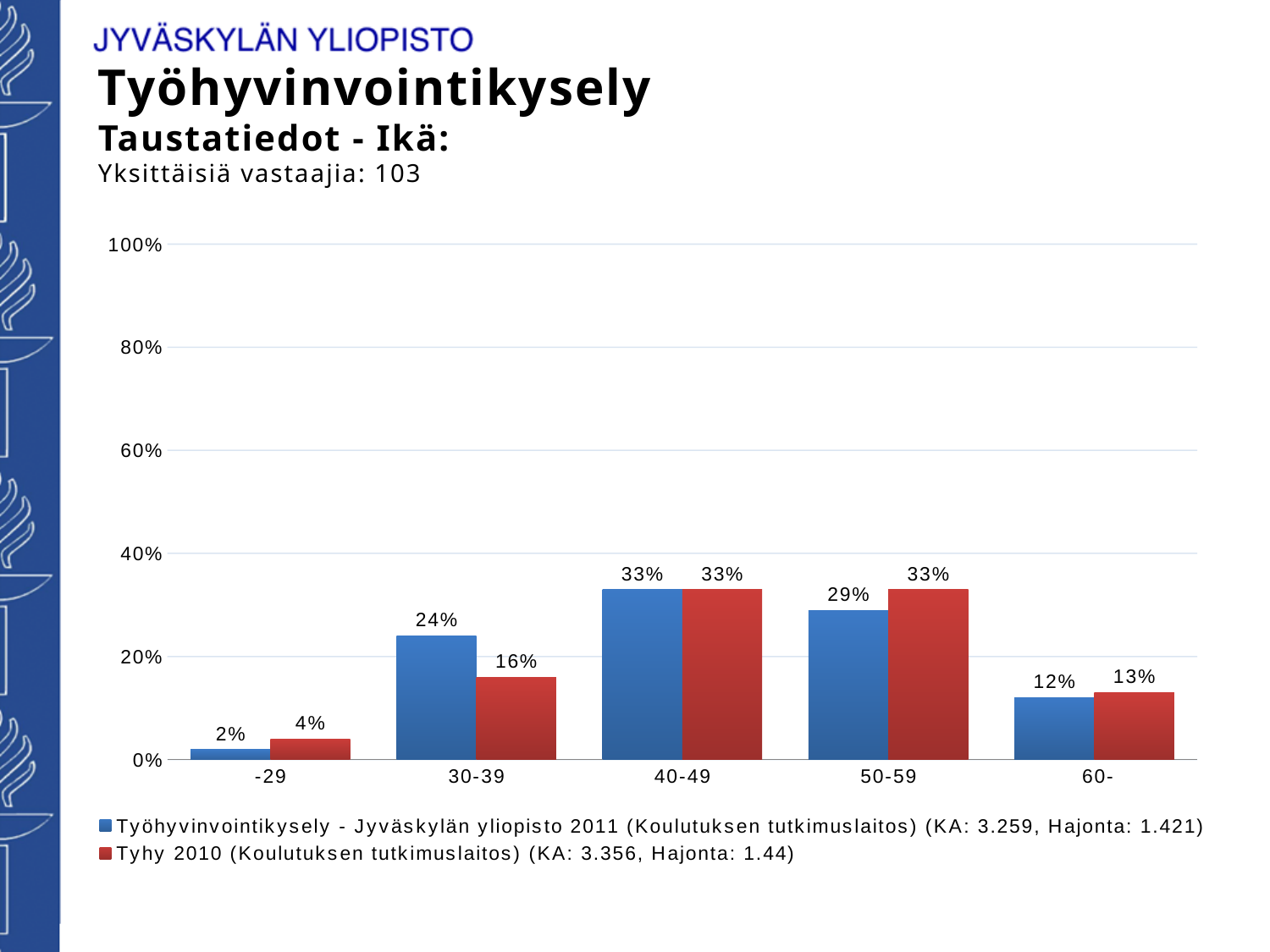
What is the value for the 30-39 age group in the Työhyvinvointikysely - Jyväskylän yliopisto 2011 series? 24% What colour are the bars for the Tyhy 2010 series? red What kind of chart is shown on the slide? bar chart What is the value for the 50-59 age group in the Tyhy 2010 series? 33% How many series does the legend list? 2 What is the difference between the 2011 and Tyhy 2010 values for the 30-39 age group? 8% For the 50-59 age group, which series has the larger value: Työhyvinvointikysely 2011 or Tyhy 2010? Tyhy 2010 Which age group has the lowest value in the Tyhy 2010 series? -29 How many age categories are shown on the x axis? 5 Is the value for the 60- age group in the Tyhy 2010 series greater or less than 20%? less What is the value for the -29 age group in the Tyhy 2010 series? 4% Which age group has the highest value in the Työhyvinvointikysely - Jyväskylän yliopisto 2011 series? 40-49